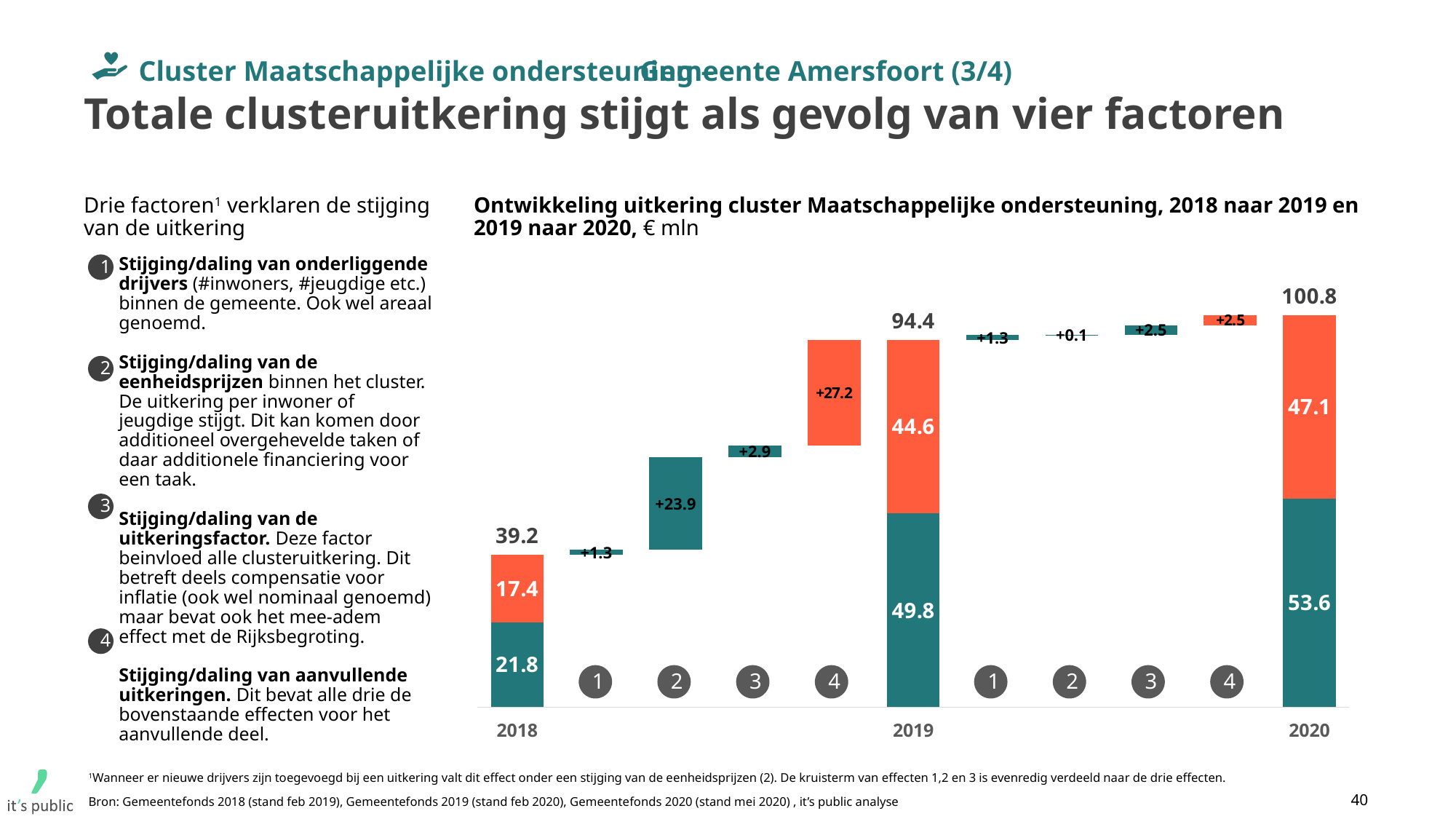
Do the total values rise or fall from 2018 to 2020? Rise Which is larger: the teal segment in 2019 or the teal segment in 2020? 2020 (53.6) What is the total uitkering shown for 2020? 100.8 What is the total uitkering shown for 2018? 39.2 What is the value of step 2 (eenheidsprijzen) between 2018 and 2019? +23.9 By how much did the total uitkering increase from 2019 to 2020? 6.4 Which step between 2018 and 2019 has the largest increase? Step 4 (+27.2) What is the total uitkering shown for 2019? 94.4 By how much did the total uitkering increase from 2018 to 2019? 55.2 What is the value of the teal (bottom) segment of the 2018 bar? 21.8 Which step between 2019 and 2020 has the smallest increase? Step 2 (+0.1) What is the value of the orange (top) segment of the 2020 bar? 47.1